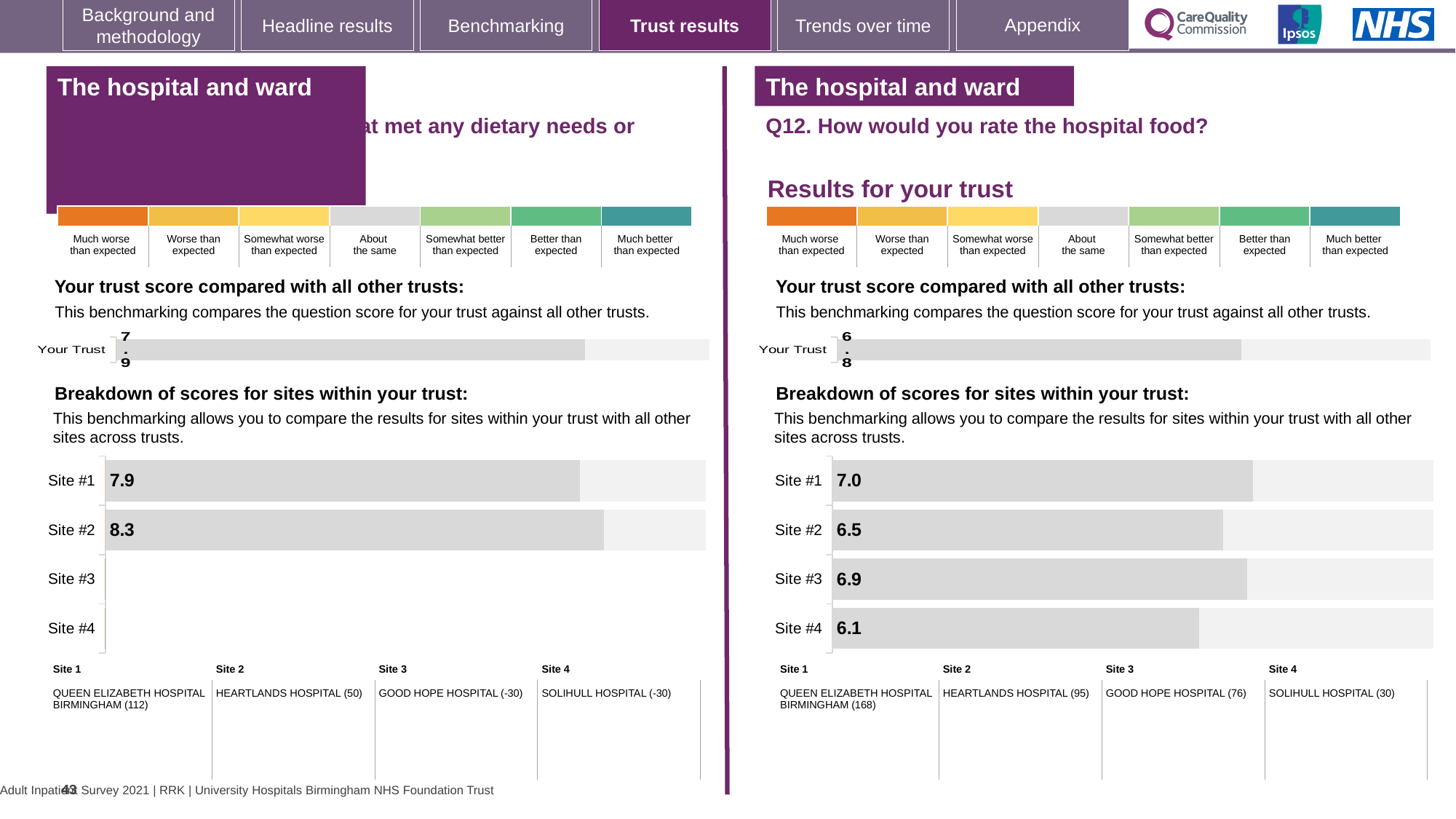
On the right-hand chart (Q12, hospital food), what is the score for Site #1? 7.0 On the right-hand chart (Q12, hospital food), what is the difference between the scores for Site #1 and Site #4? 0.9 On the left-hand chart (breakdown of scores for sites), what is the score for Site #1? 7.9 On the right-hand chart (Q12, hospital food), what is the score for Site #4? 6.1 On the left-hand chart (breakdown of scores for sites), what is the score for Site #2? 8.3 On the left-hand chart (breakdown of scores for sites), what is the difference between the scores for Site #2 and Site #1? 0.4 On the right-hand chart (Q12, hospital food), which site has the lowest score? Site #4 On the left-hand chart (breakdown of scores for sites), which has the higher score, Site #1 or Site #2? Site #2 On the right-hand chart (Q12, hospital food), which site has the highest score? Site #1 What type of chart is used for the breakdown of scores for sites on the right-hand side of the slide? Bar chart On the right-hand side of the slide, what is the 'Your Trust' score for Q12? 6.8 On the right-hand chart (Q12, hospital food), which has the higher score, Site #2 or Site #3? Site #3